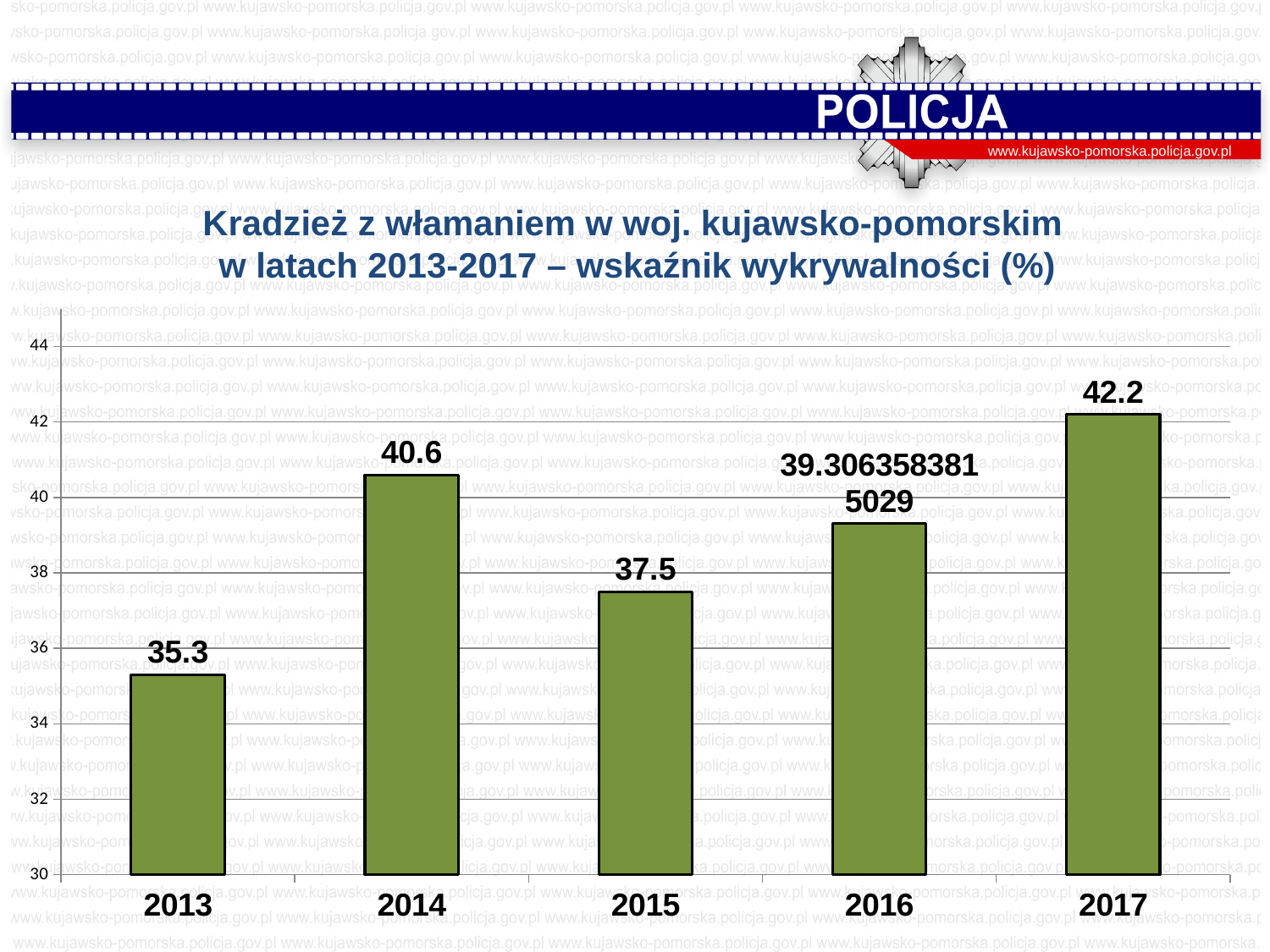
What is the value for 2017? 42.2 What is the difference between the values for 2014 and 2015? 3.1 What is the difference between the values for 2017 and 2013? 6.9 Is the value for 2016 greater or less than 40? less Which is larger, the value for 2014 or the value for 2016? 2014 Which year has the lowest value? 2013 How many years are shown on the x axis? 5 What is the value for 2013? 35.3 What kind of chart is shown on the slide? bar chart What is the value for 2015? 37.5 What is the value for 2014? 40.6 Which year has the highest value? 2017